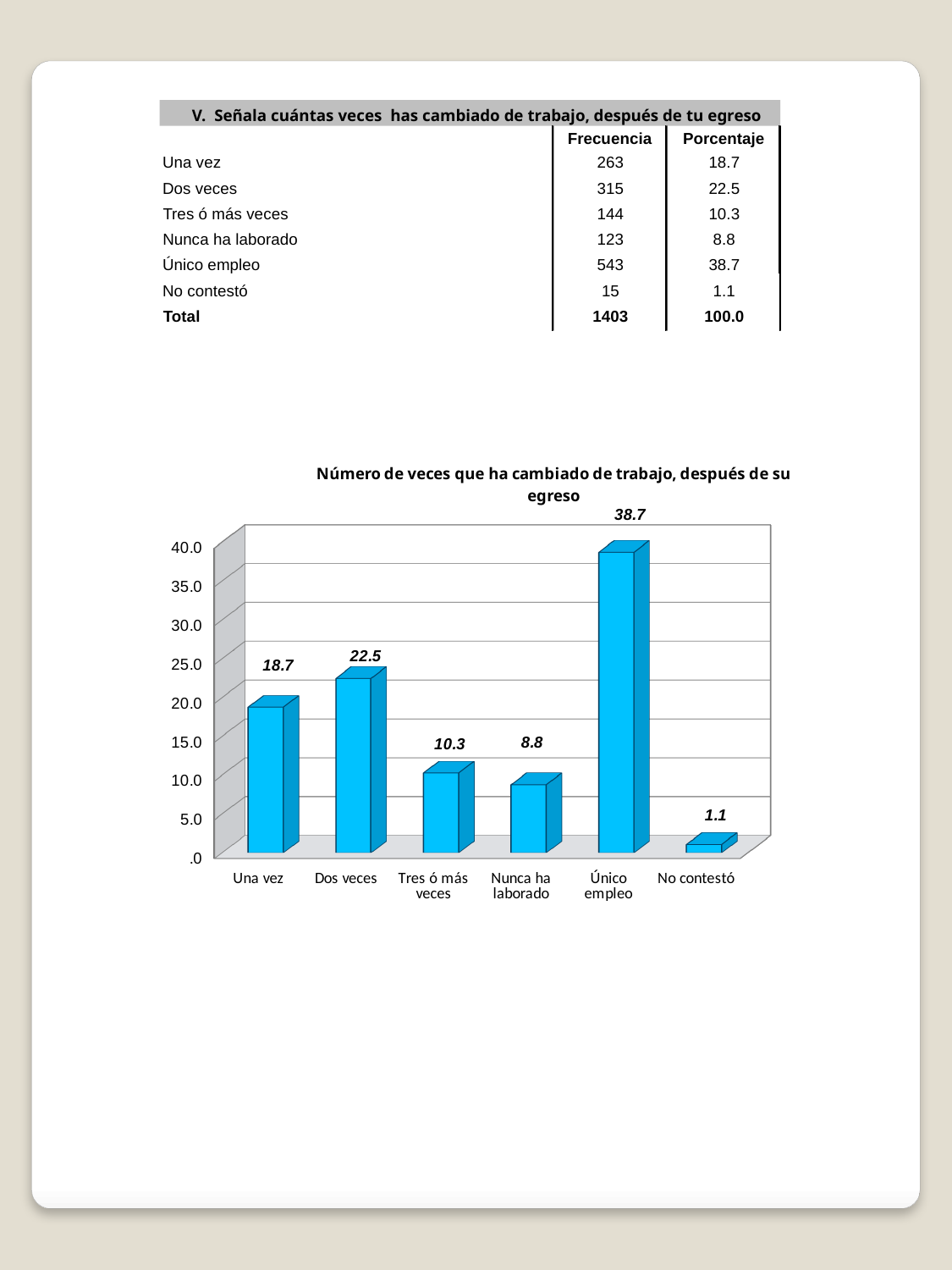
What is the value for Único empleo? 38.7 What kind of chart is shown? bar chart Which category has the lowest value? No contestó What is the title of the chart? Número de veces que ha cambiado de trabajo, después de su egreso What is the value for Dos veces? 22.5 What is the difference between the values for Único empleo and Dos veces? 16.2 Is the value for Una vez greater or less than 20.0? less Which category has the highest value? Único empleo Which is larger, the value for Tres ó más veces or the value for Nunca ha laborado? Tres ó más veces How many categories are shown on the x axis? 6 What is the value for No contestó? 1.1 What is the difference between the values for Una vez and Nunca ha laborado? 9.9